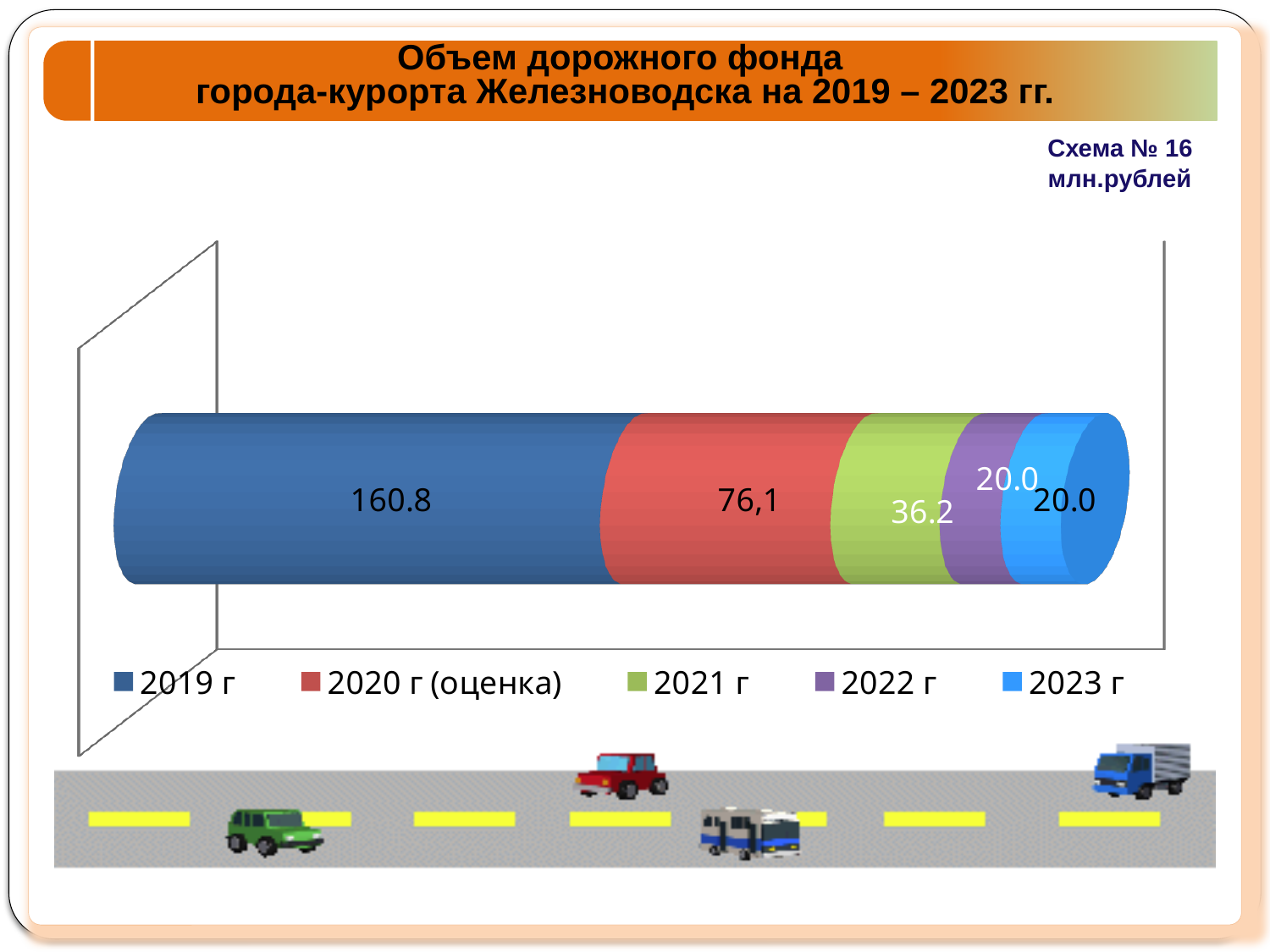
Which year has the highest value? 2019 г What is the value for 2021 г? 36.2 What is the total of the stacked bar? 313.1 What is the value for 2020 г (оценка)? 76,1 What is the difference between the values for 2019 г and 2021 г? 124.6 What is the value for 2023 г? 20.0 What unit is stated for the chart values? млн.рублей What is the value for 2022 г? 20.0 What is the value for 2019 г? 160.8 Which is larger, the value for 2020 г (оценка) or the value for 2021 г? 2020 г (оценка) How many series does the legend list? 5 What kind of chart is shown on the slide? Stacked bar chart